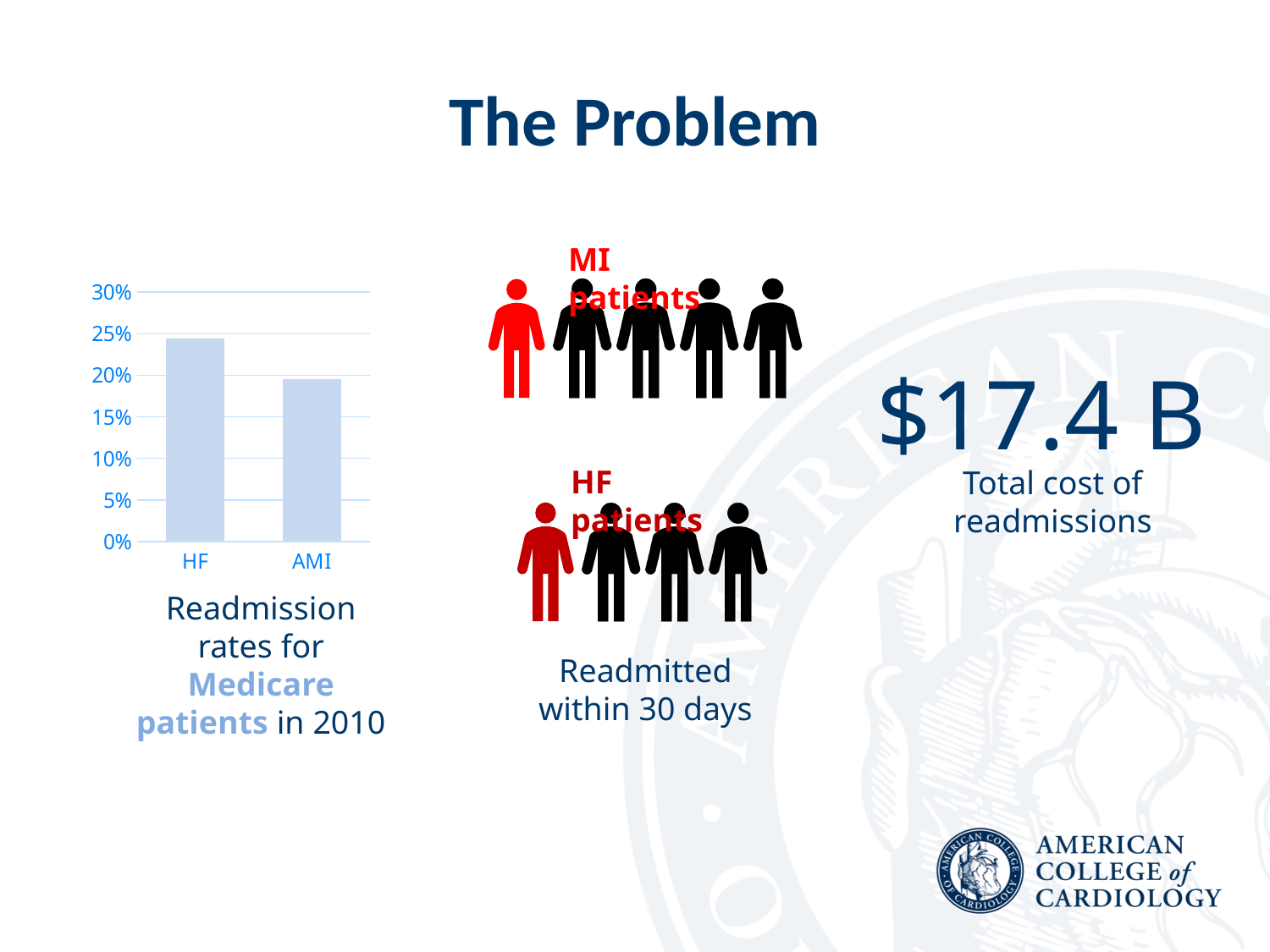
What kind of chart is shown on the slide? bar chart Which category has the lower readmission rate in the bar chart? AMI What is the highest value shown on the vertical axis of the bar chart? 30% Which category has the higher readmission rate in the bar chart? HF Is the value for HF greater or less than 30%? less Is the value for AMI greater or less than 15%? greater Is the value for AMI greater or less than 25%? less According to the caption under the bar chart, what do the bars represent? Readmission rates for Medicare patients in 2010 How many categories does the bar chart show? 2 Is the readmission rate for HF larger or smaller than the rate for AMI? larger